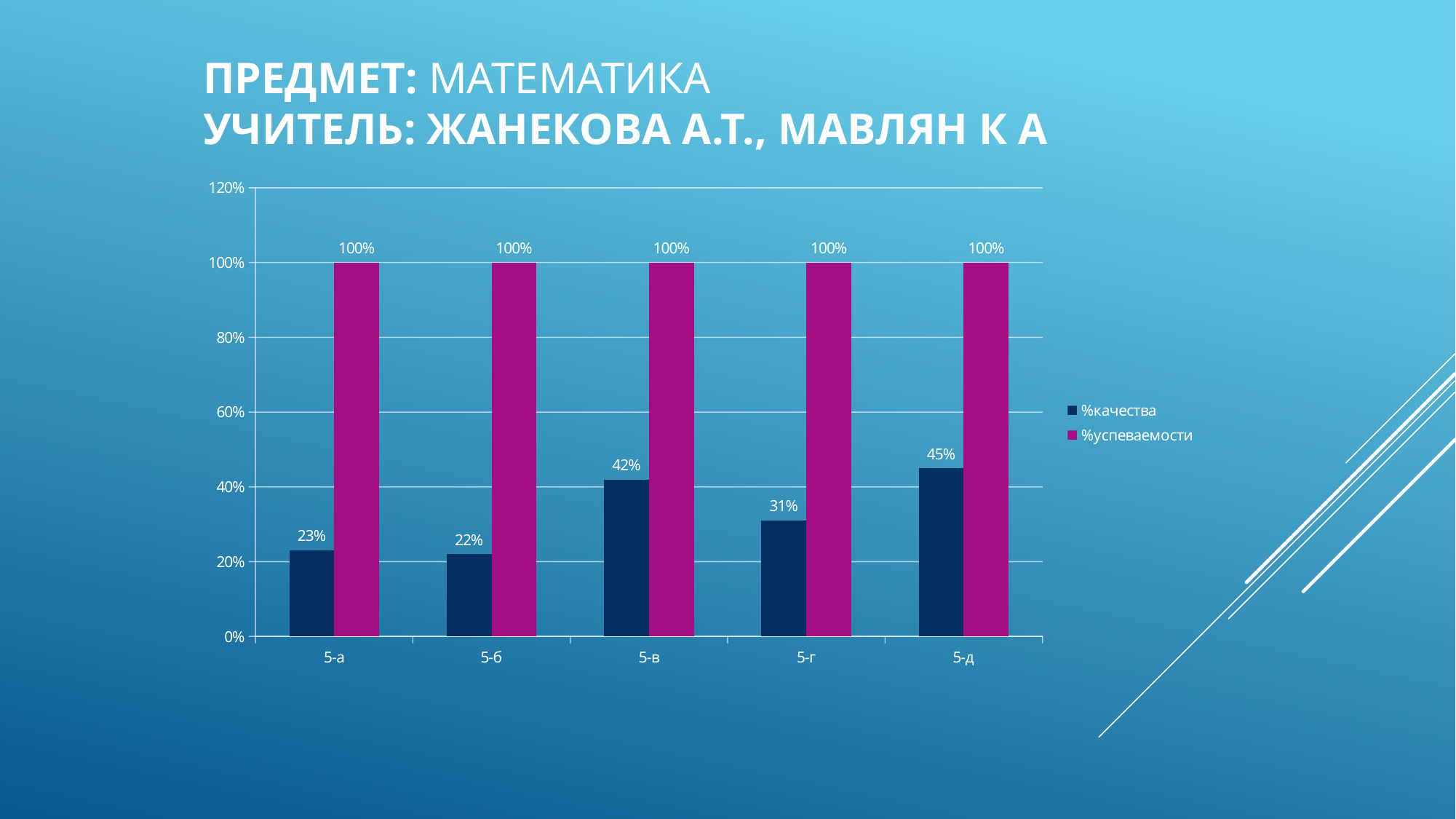
Which colour represents the %успеваемости series? magenta What kind of chart is shown on the slide? bar chart What is the %качества value for class 5-в? 42% Which class has the lowest %качества? 5-б What is the %успеваемости value for class 5-г? 100% What is the %качества value for class 5-а? 23% Which class has the highest %качества? 5-д How many series does the legend list? 2 Is the %качества value for 5-б greater or less than 40%? less How many classes are shown on the x axis? 5 What is the difference between the %качества values for 5-д and 5-г? 14% Which class has a higher %качества, 5-в or 5-г? 5-в